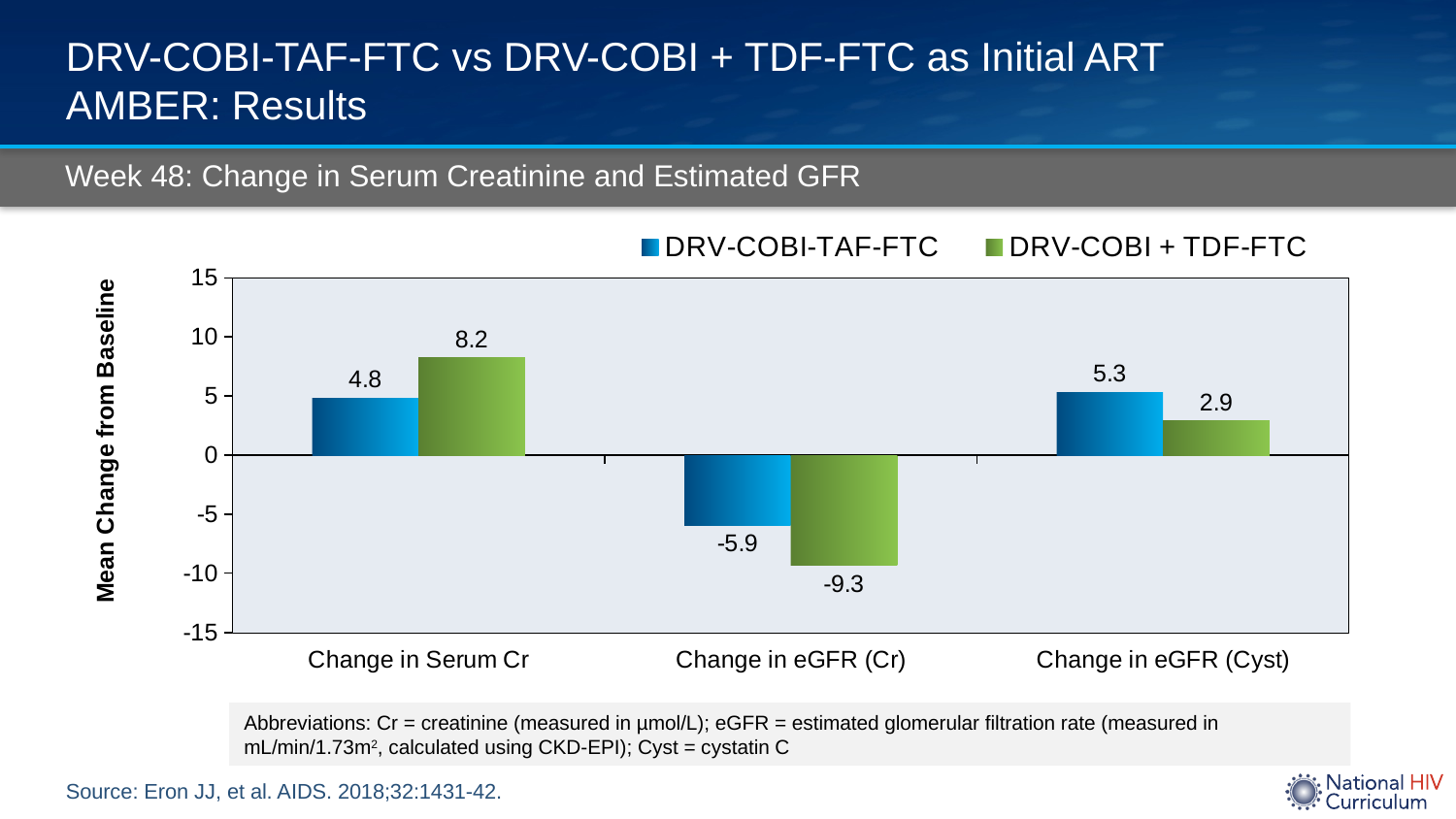
What is the value for DRV-COBI-TAF-FTC in the Change in Serum Cr category? 4.8 What is the value for DRV-COBI + TDF-FTC in the Change in Serum Cr category? 8.2 What is the label of the y axis? Mean Change from Baseline Which category has the highest value for the DRV-COBI + TDF-FTC series? Change in Serum Cr What is the difference between the DRV-COBI + TDF-FTC and DRV-COBI-TAF-FTC values in the Change in Serum Cr category? 3.4 How many categories are shown on the x axis? 3 What kind of chart is shown on the slide? Bar chart What is the value for DRV-COBI + TDF-FTC in the Change in eGFR (Cr) category? -9.3 What is the value for DRV-COBI-TAF-FTC in the Change in eGFR (Cyst) category? 5.3 Which category has the lowest value for the DRV-COBI-TAF-FTC series? Change in eGFR (Cr) In the Change in eGFR (Cyst) category, which series has the larger value? DRV-COBI-TAF-FTC How many series does the legend list? 2